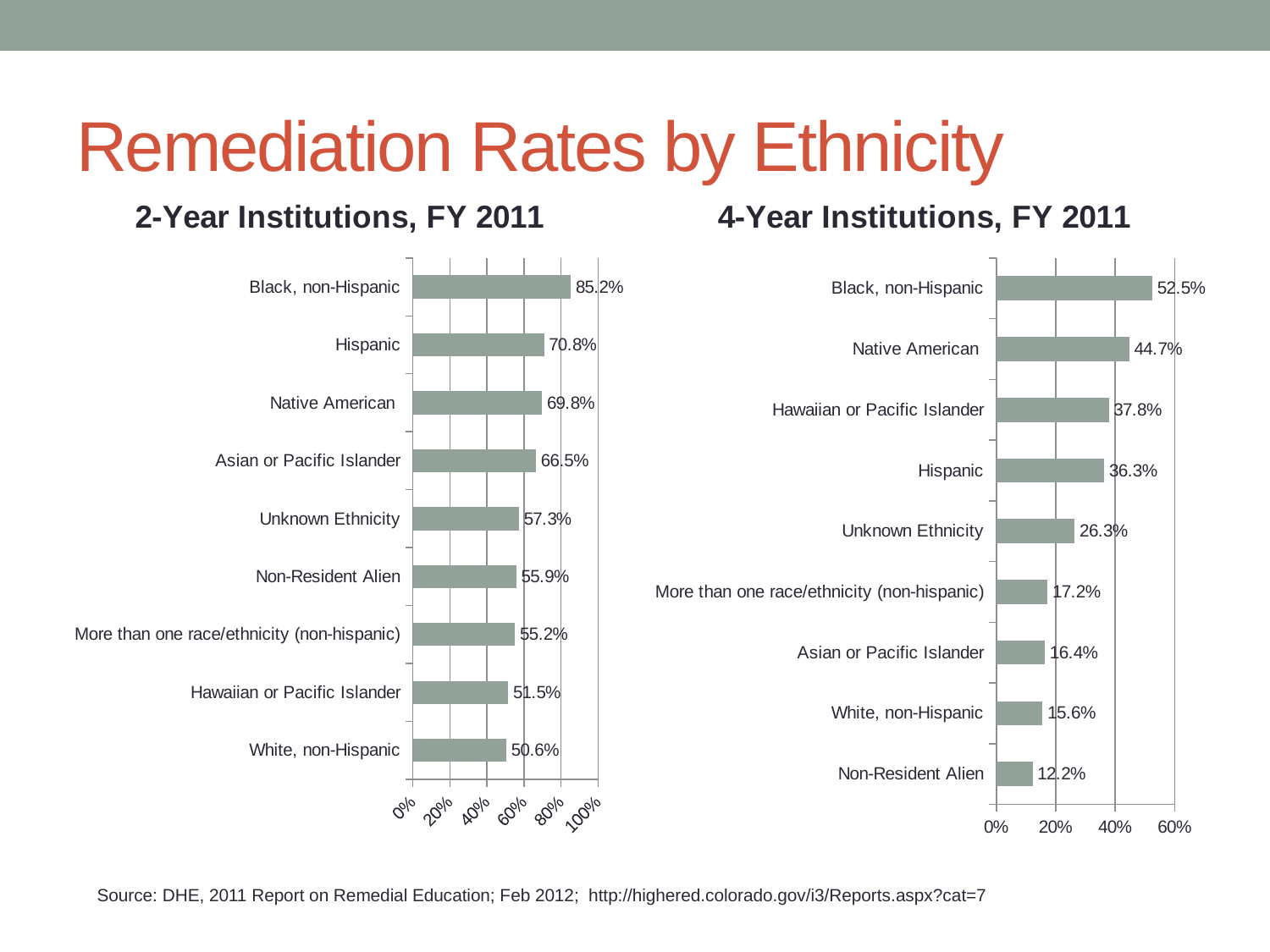
In the 2-Year Institutions, FY 2011 chart, is the value for Unknown Ethnicity greater or less than 60%? less In the 4-Year Institutions, FY 2011 chart, which category has the lowest remediation rate? Non-Resident Alien What kind of chart is the 2-Year Institutions, FY 2011 chart? Bar chart In the 4-Year Institutions, FY 2011 chart, what is the remediation rate for Asian or Pacific Islander students? 16.4% In the 2-Year Institutions, FY 2011 chart, what is the remediation rate for Hispanic students? 70.8% In the 2-Year Institutions, FY 2011 chart, what is the difference between the rates for Black, non-Hispanic and White, non-Hispanic? 34.6% In the 2-Year Institutions, FY 2011 chart, which category has the highest remediation rate? Black, non-Hispanic In the 4-Year Institutions, FY 2011 chart, which is larger: the rate for Hawaiian or Pacific Islander or the rate for Hispanic? Hawaiian or Pacific Islander In the 2-Year Institutions, FY 2011 chart, what is the remediation rate for Hawaiian or Pacific Islander students? 51.5% What is the title of the slide containing the two charts? Remediation Rates by Ethnicity In the 4-Year Institutions, FY 2011 chart, what is the remediation rate for Native American students? 44.7% How many categories are shown in the 4-Year Institutions, FY 2011 chart? 9